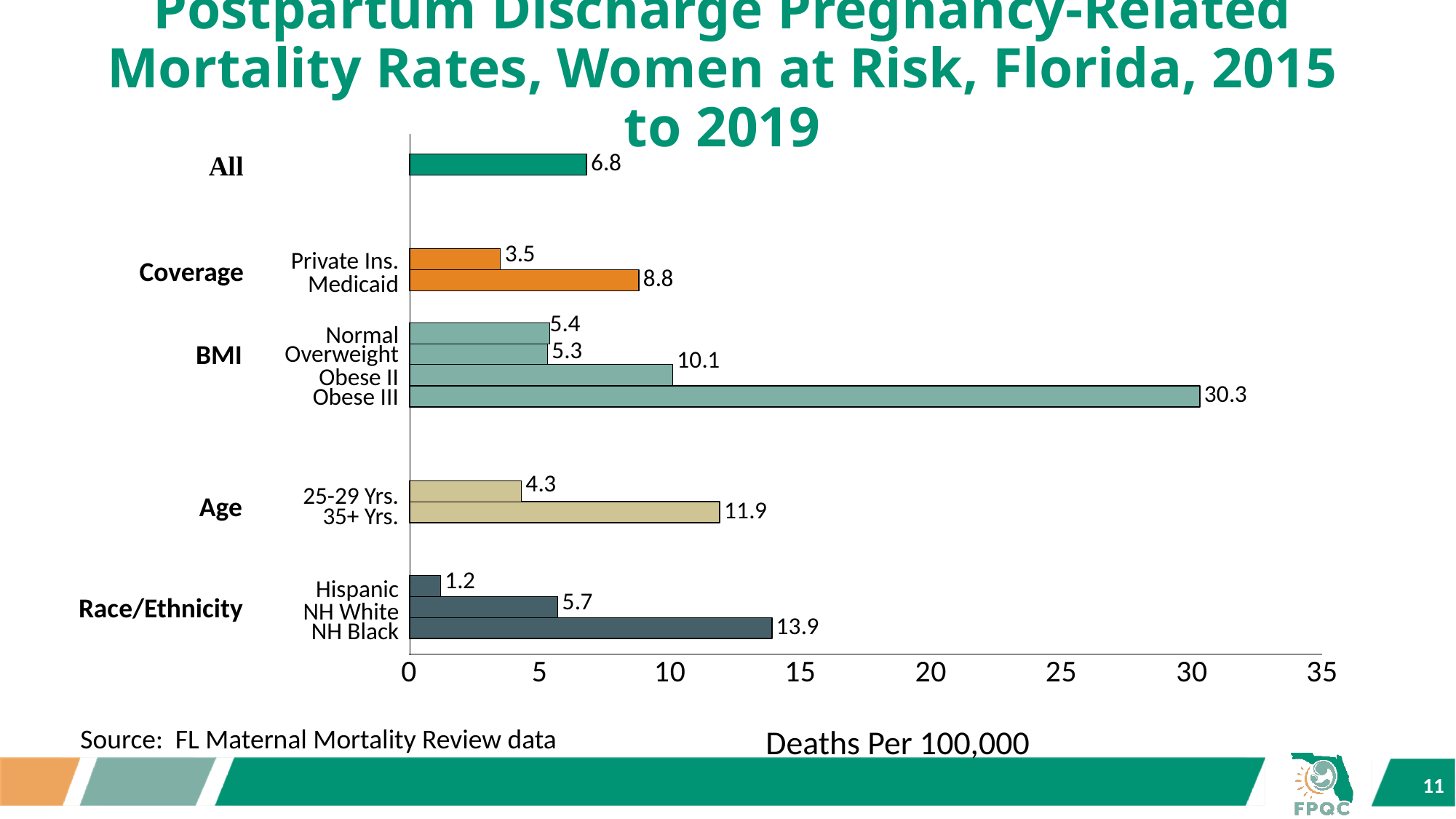
What is the mortality rate for Medicaid coverage? 8.8 What is the mortality rate for the All category? 6.8 What is the x-axis label of the chart? Deaths Per 100,000 What is the mortality rate for NH Black women? 13.9 What kind of chart is shown on the slide? Bar chart What is the mortality rate for Obese III? 30.3 Which category has the lowest mortality rate? Hispanic What is the difference between the mortality rates for Medicaid and Private Ins.? 5.3 Which has a higher mortality rate, NH White or NH Black? NH Black Is the value for Obese II greater or less than 10? greater Which category has the highest mortality rate? Obese III What is the difference between the mortality rates for 35+ Yrs. and 25-29 Yrs.? 7.6